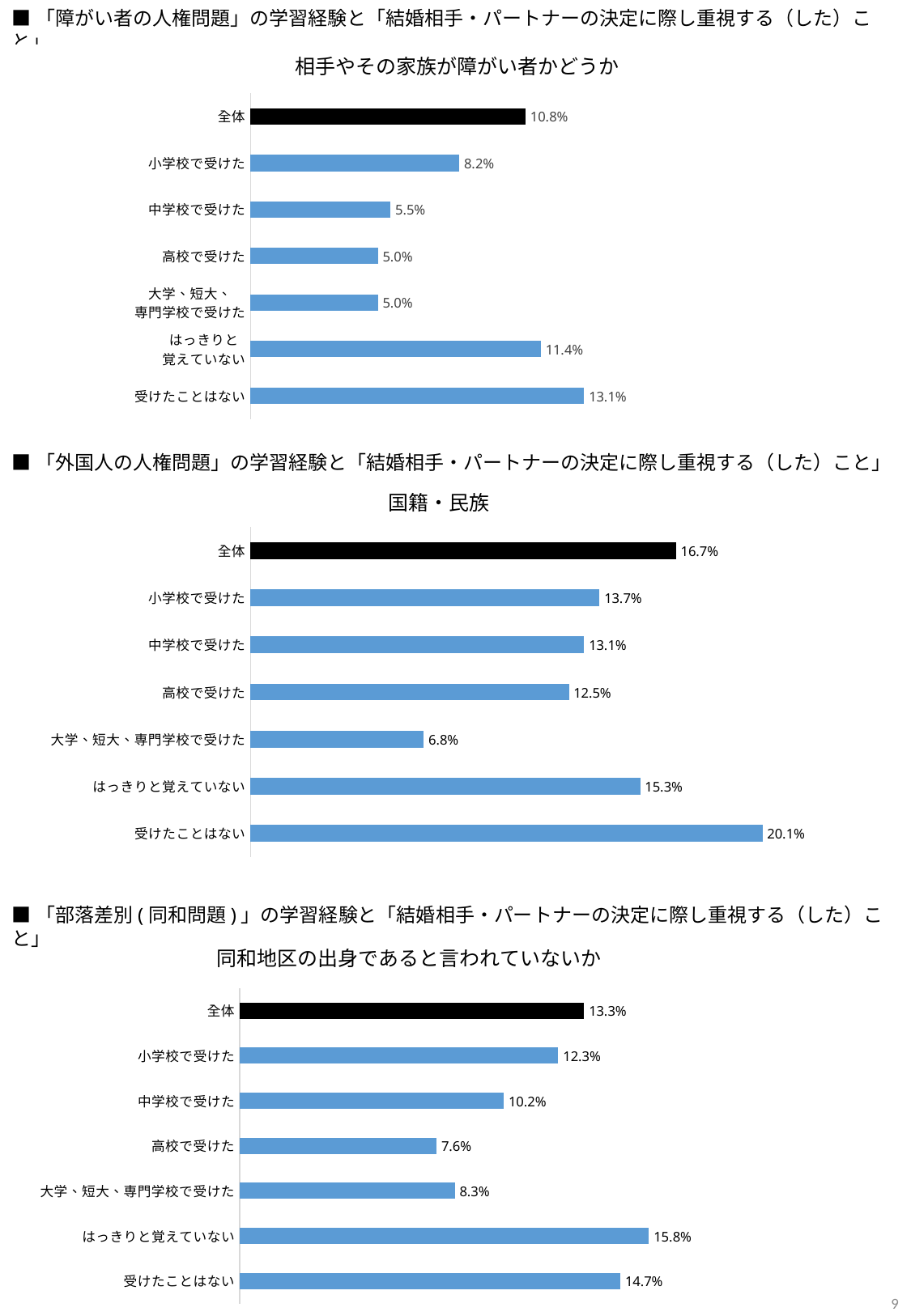
In the bottom chart titled 「同和地区の出身であると言われていないか」, what is the value for 高校で受けた? 7.6% In the middle chart titled 「国籍・民族」, what is the value for 大学、短大、専門学校で受けた? 6.8% In the top chart titled 「相手やその家族が障がい者かどうか」, what is the difference between 受けたことはない and 小学校で受けた? 4.9% In the middle chart titled 「国籍・民族」, which is larger, はっきりと覚えていない or 全体? 全体 In the bottom chart titled 「同和地区の出身であると言われていないか」, which category has the highest value? はっきりと覚えていない In the middle chart titled 「国籍・民族」, how many categories are plotted? 7 In the middle chart titled 「国籍・民族」, which category has the lowest value? 大学、短大、専門学校で受けた In the top chart titled 「相手やその家族が障がい者かどうか」, what is the value for 全体? 10.8% In the top chart titled 「相手やその家族が障がい者かどうか」, which category has the highest value? 受けたことはない In the bottom chart titled 「同和地区の出身であると言われていないか」, what is the difference between 全体 and 中学校で受けた? 3.1% What kind of chart is the bottom chart titled 「同和地区の出身であると言われていないか」? Bar chart In the top chart titled 「相手やその家族が障がい者かどうか」, what colour is the bar for 全体? Black